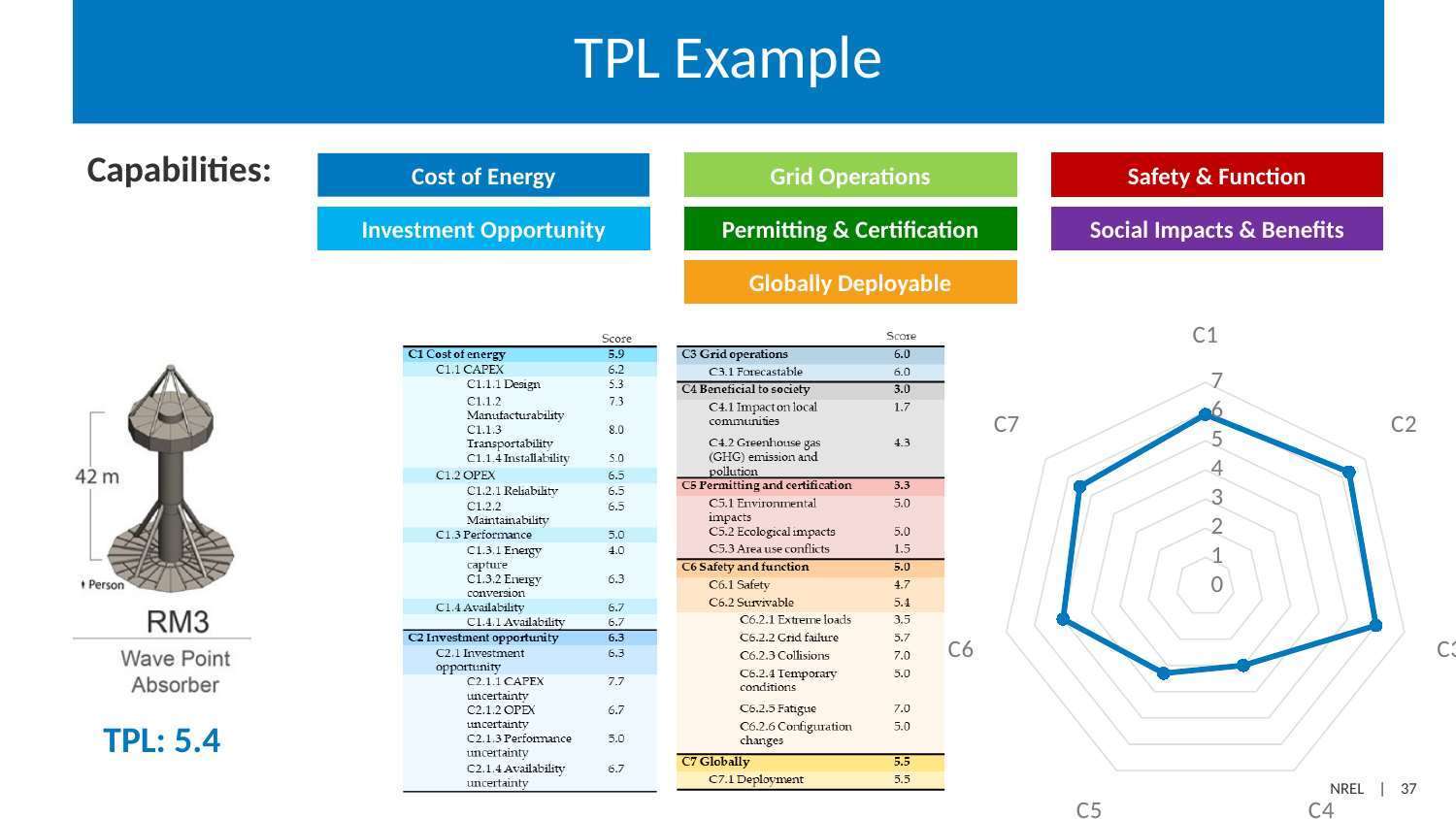
How many categories (axes) does the radar chart have? 7 In the radar chart, is the value for C4 greater or less than 4? less In the radar chart, is the value for C7 greater or less than 4? greater Which category label appears at the top of the radar chart? C1 In the radar chart, is the value for C5 greater or less than 4? less What kind of chart is shown on the right side of the slide? radar chart In the radar chart, which has the larger value, C2 or C4? C2 In the radar chart, which has the larger value, C1 or C5? C1 What is the highest tick value shown on the radar chart's axis? 7